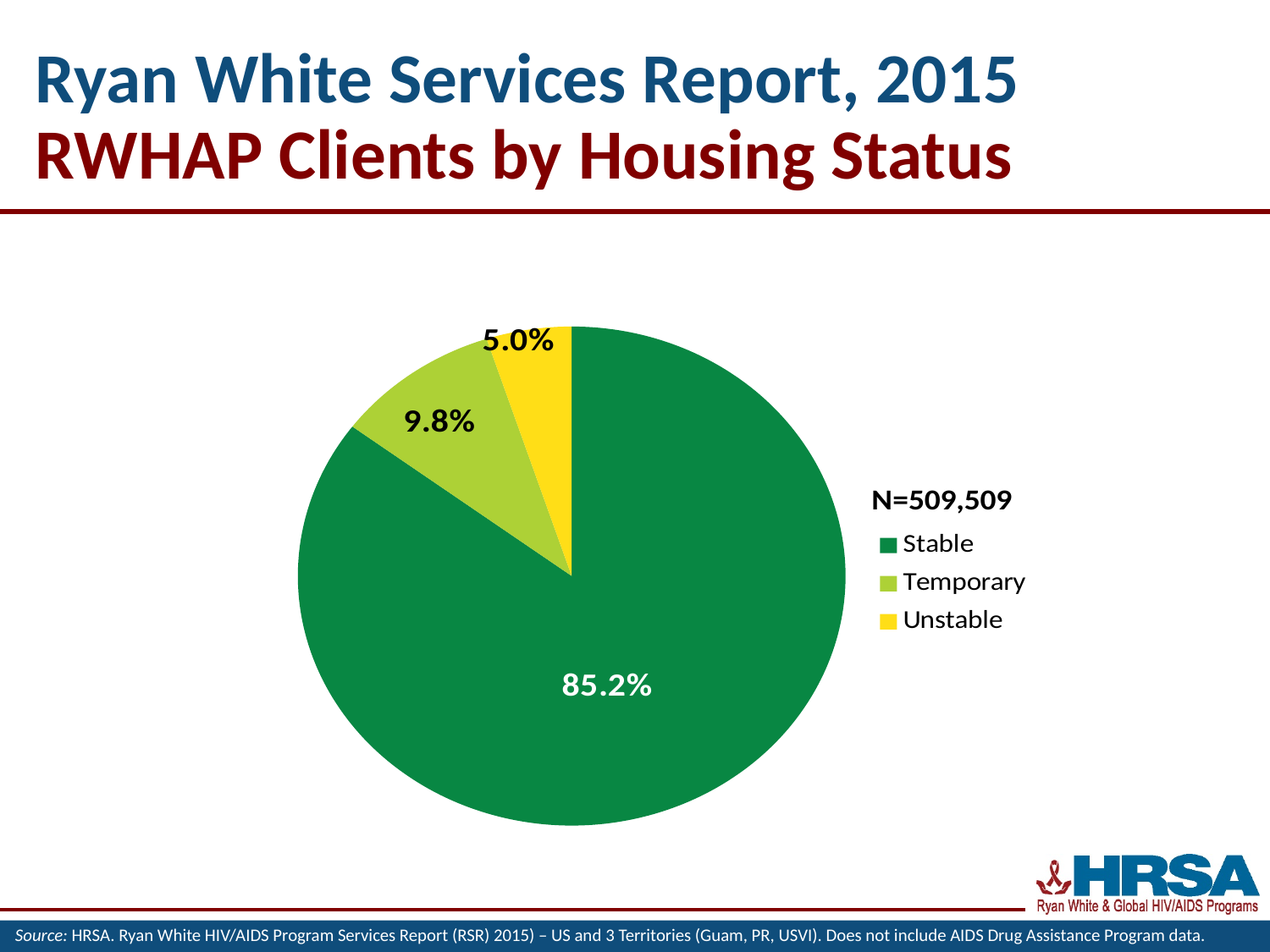
What is the total number of clients (N) shown next to the legend? N=509,509 Which housing status category has the largest share of clients? Stable What is the difference in percentage points between the Temporary and Unstable shares? 4.8 How many housing status categories does the pie chart show? 3 Which colour represents the Unstable category in the pie chart? yellow What type of chart is shown on the slide? pie chart What is the difference in percentage points between the Stable and Temporary shares? 75.4 Which is larger, the share for Temporary or the share for Unstable? Temporary Which housing status category has the smallest share of clients? Unstable What share of RWHAP clients have Temporary housing status? 9.8% What share of RWHAP clients have Stable housing status? 85.2% What share of RWHAP clients have Unstable housing status? 5.0%